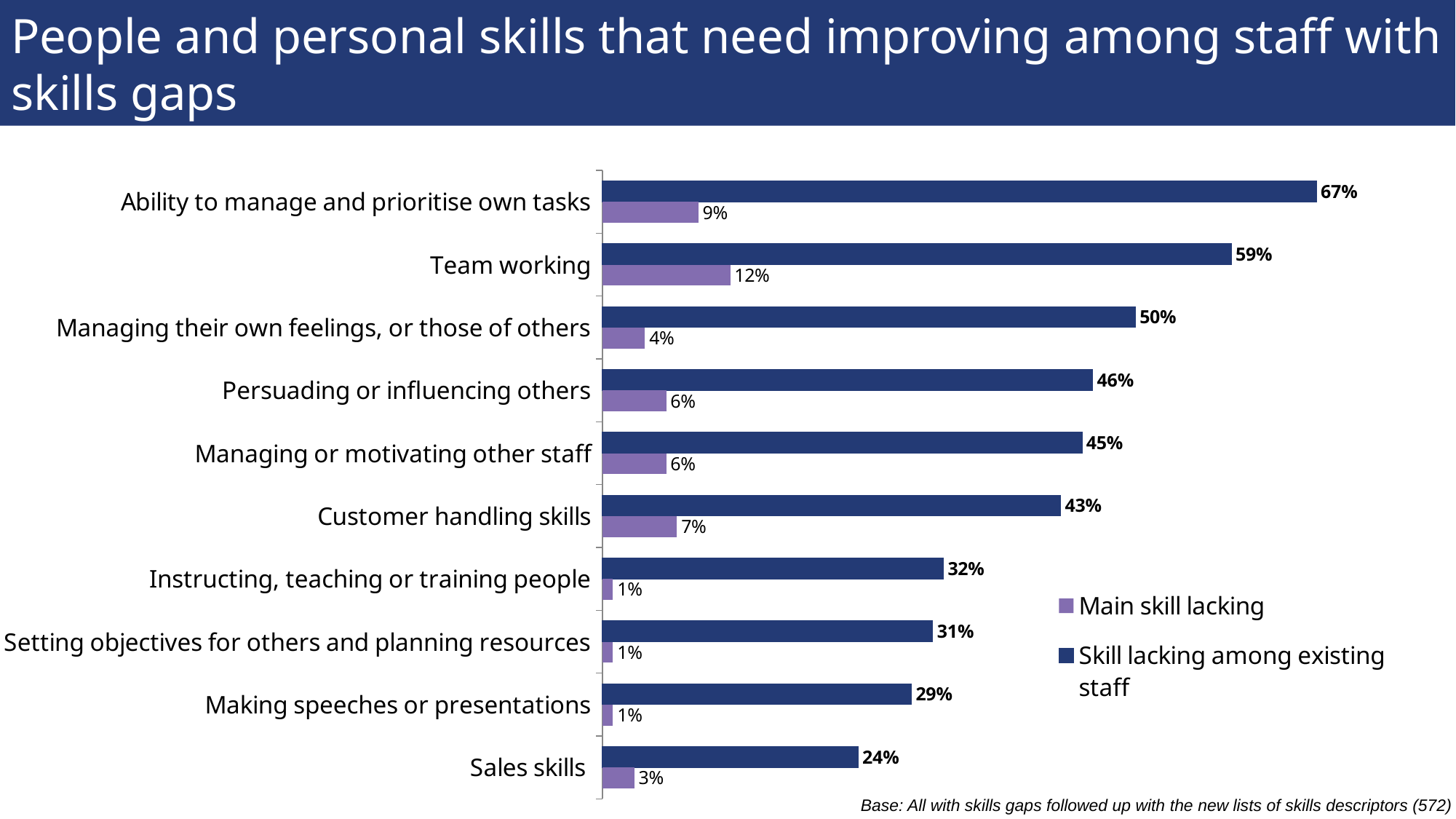
What is the value for 'Skill lacking among existing staff' for Team working? 59% How many categories are shown on the chart? 10 What is the difference between the 'Skill lacking among existing staff' values for Ability to manage and prioritise own tasks and Sales skills? 43 percentage points Which is larger: the 'Main skill lacking' value for Team working or for Ability to manage and prioritise own tasks? Team working How many series does the legend list? 2 What is the value for 'Main skill lacking' for Customer handling skills? 7% Which category has the highest value for 'Main skill lacking'? Team working What is the difference between the 'Skill lacking among existing staff' and 'Main skill lacking' values for Managing their own feelings, or those of others? 46 percentage points What kind of chart is shown on the slide? Bar chart Which colour represents the 'Main skill lacking' series? Purple Which category has the highest value for 'Skill lacking among existing staff'? Ability to manage and prioritise own tasks Which category has the lowest value for 'Skill lacking among existing staff'? Sales skills